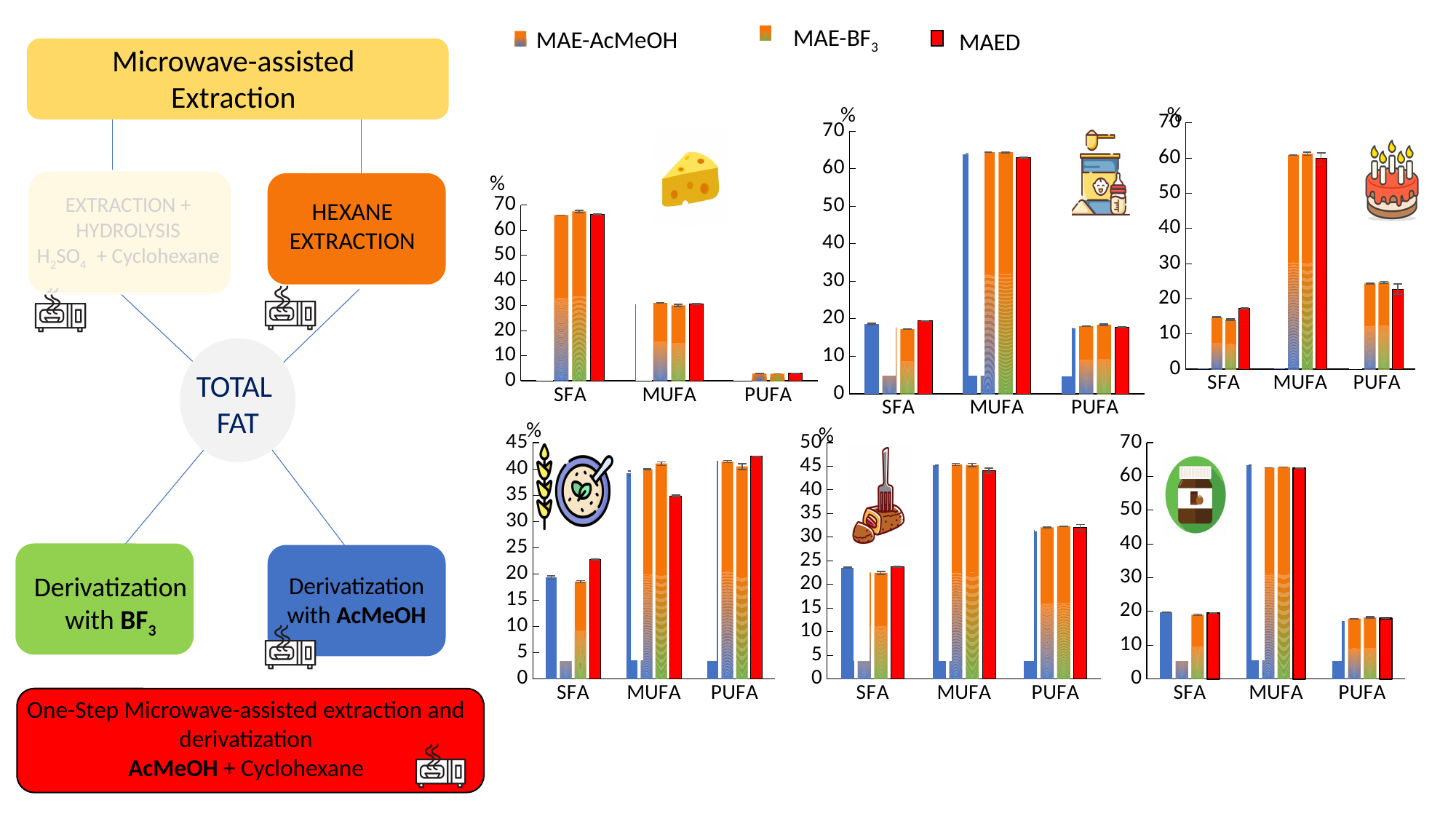
What kind of chart is the top-left chart (with the cheese icon)? bar chart How many series does the legend at the top of the slide list? 3 Which series is shown in solid red in the legend? MAED In the top-left chart (cheese icon), which category has the highest values? SFA In the top-right chart (cake icon), which category has the lowest values? SFA In the bottom-middle chart (meat icon), which is larger, the MAED value for MUFA or for PUFA? MUFA In the top-middle chart (baby food icon), which category has the highest values? MUFA How many categories are shown on the x axis of the top-middle chart? 3 In the top-left chart (cheese icon), is the MAED value for SFA greater or less than 60? greater In the bottom-right chart (jar icon), is the MAED value for MUFA greater or less than 60? greater In the top-left chart (cheese icon), do the values rise or fall from SFA to PUFA along the x axis? fall In the top-right chart (cake icon), is the MAED value for PUFA greater or less than 20? greater